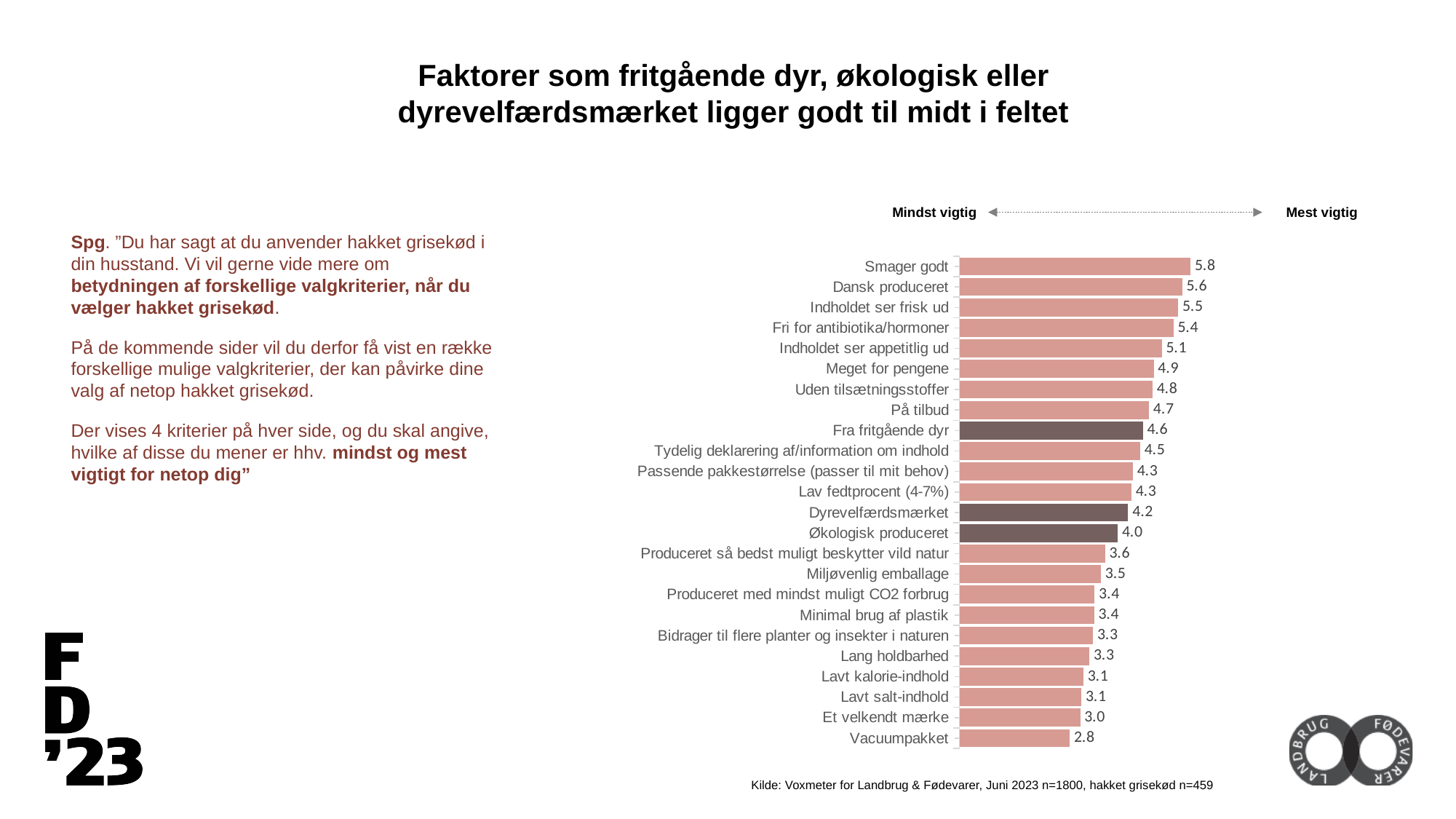
What kind of chart is shown on the slide? Bar chart What is the value for "Dyrevelfærdsmærket"? 4.2 Which three categories are highlighted with darker bars? Fra fritgående dyr, Dyrevelfærdsmærket, Økologisk produceret What is the value for "Smager godt"? 5.8 What is the difference between the values for "Fra fritgående dyr" and "Økologisk produceret"? 0.6 Which category has the lowest value? Vacuumpakket Which category has the highest value? Smager godt What is the value for "Fra fritgående dyr"? 4.6 What is the value for "Økologisk produceret"? 4.0 How many categories are shown in the chart? 24 Which has a larger value, "Dansk produceret" or "Meget for pengene"? Dansk produceret What is the difference between the values for "Smager godt" and "Vacuumpakket"? 3.0